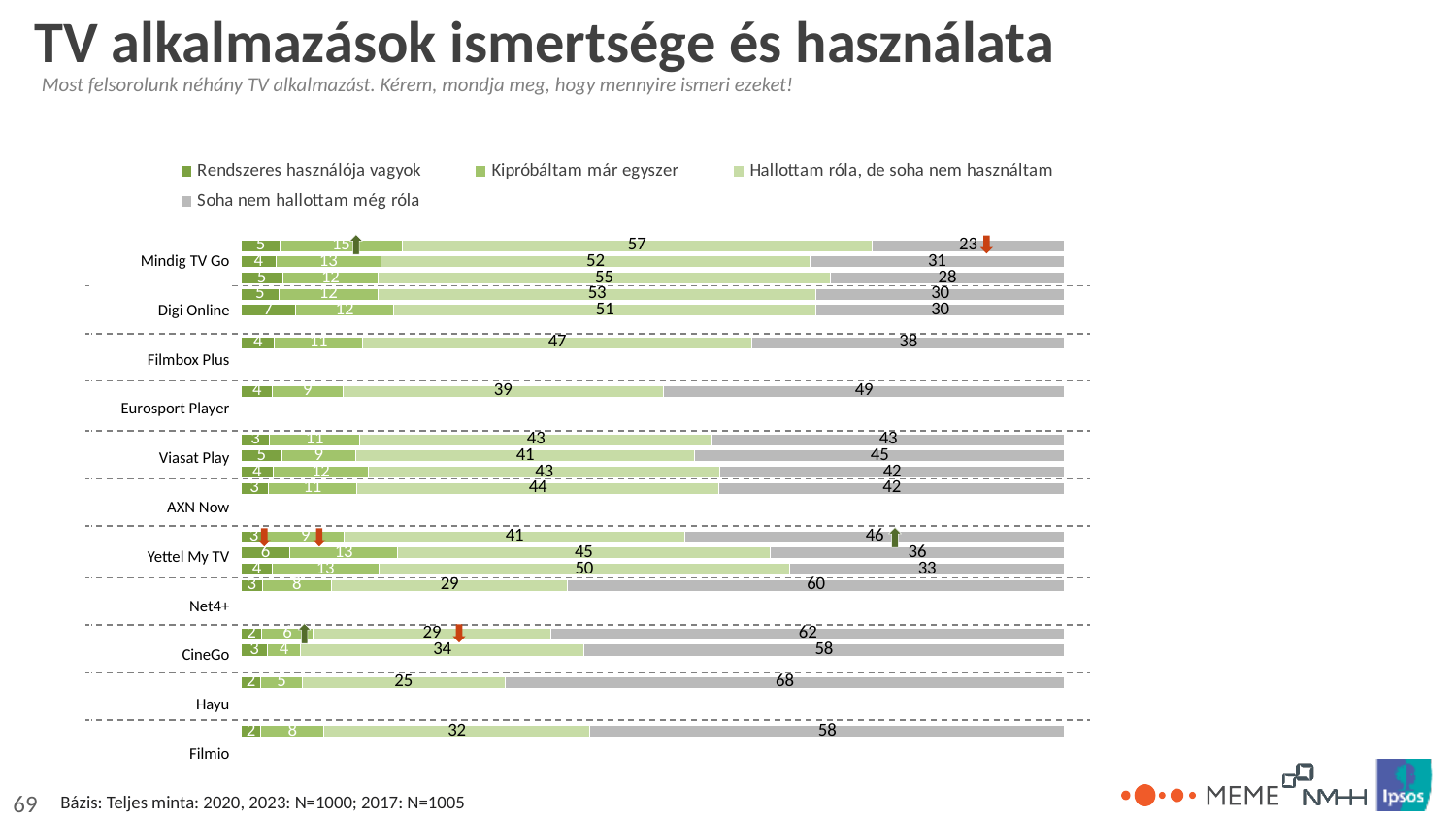
What is the total of the stacked bar for Hayu? 100 What is the value of 'Soha nem hallottam még róla' for Hayu? 68 How many TV applications are listed as categories on the chart? 11 Which TV application has the highest value for 'Soha nem hallottam még róla'? Hayu How many series does the legend list? 4 What is the difference between the 'Soha nem hallottam még róla' values for Net4+ and Filmio? 2 What is the value of 'Kipróbáltam már egyszer' for AXN Now? 11 What is the value of 'Soha nem hallottam még róla' for Filmbox Plus? 38 What is the first legend entry on the chart? Rendszeres használója vagyok What is the value of 'Hallottam róla, de soha nem használtam' for Eurosport Player? 39 What kind of chart is shown on the slide? bar chart Which has a larger 'Hallottam róla, de soha nem használtam' value, Filmio or Hayu? Filmio